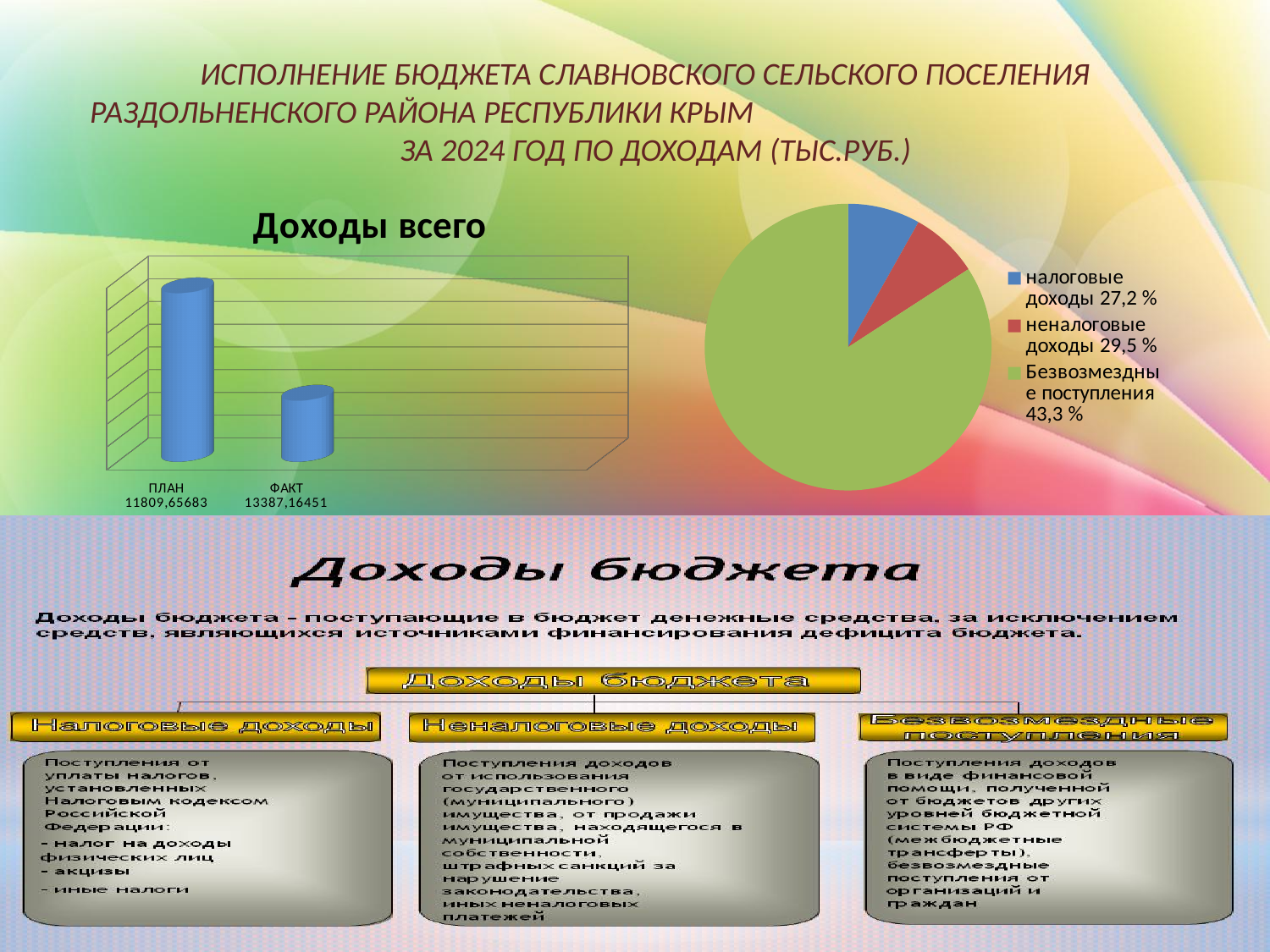
In the "Доходы всего" chart, what value is shown for ПЛАН? 11809,65683 What kind of chart is shown on the right of the slide, next to the legend? pie chart How many bars are plotted in the "Доходы всего" chart? 2 In the pie chart, what share is shown for неналоговые доходы? 29,5 % In the pie chart, what share is shown for налоговые доходы? 27,2 % In the "Доходы всего" chart, what value is shown for ФАКТ? 13387,16451 What kind of chart is the "Доходы всего" chart on the left? bar chart In the pie chart, which is larger: Безвозмездные поступления or налоговые доходы? Безвозмездные поступления In the pie chart, what share is shown for Безвозмездные поступления? 43,3 % How many entries does the legend of the pie chart list? 3 In the pie chart, which category has the largest share? Безвозмездные поступления What colour is the Безвозмездные поступления slice in the pie chart? green